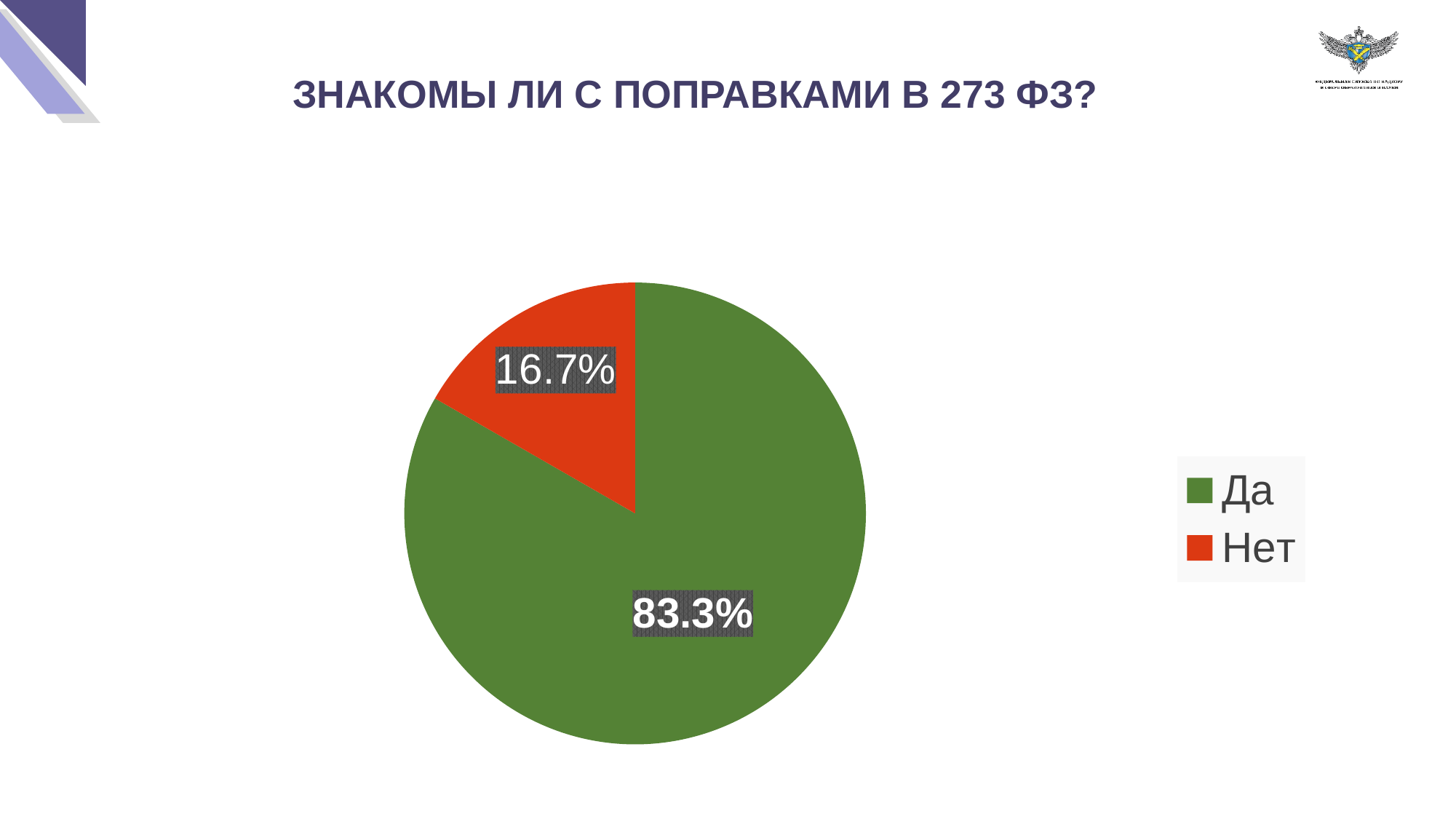
What type of chart is shown on the slide? pie chart How many entries does the legend list? 2 What is the value for Да? 83.3% How many slices does the pie chart have? 2 Which category has the smallest share of the pie? Нет What is the difference between the values for Да and Нет? 66.6% Which is larger, the value for Да or the value for Нет? Да Which category has the largest share of the pie? Да What is the value for Нет? 16.7% What colour is the Нет slice? red What share of the pie does the Нет slice represent? 16.7% What is the title of the slide above the chart? ЗНАКОМЫ ЛИ С ПОПРАВКАМИ В 273 ФЗ?